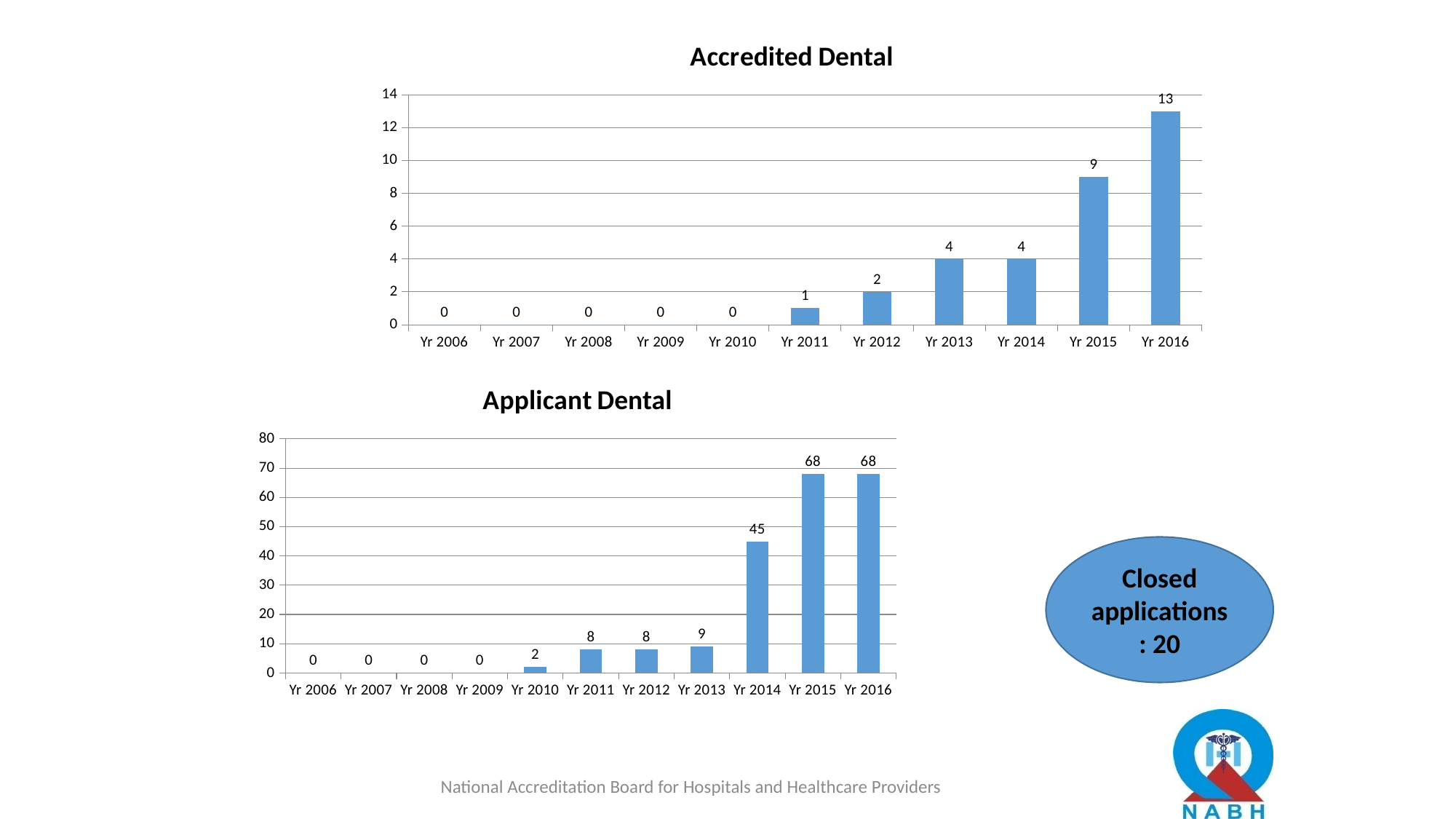
In the Accredited Dental chart, what is the value for Yr 2012? 2 In the Accredited Dental chart, how many years are shown on the x axis? 11 In the Applicant Dental chart, do the values generally rise or fall from Yr 2006 to Yr 2016? Rise In the Accredited Dental chart, what is the difference between Yr 2016 and Yr 2015? 4 In the Accredited Dental chart, what is the value for Yr 2016? 13 In the Applicant Dental chart, what is the value for Yr 2010? 2 In the Applicant Dental chart, which is larger, the value for Yr 2013 or the value for Yr 2014? Yr 2014 In the Accredited Dental chart, which year has the highest value? Yr 2016 In the Applicant Dental chart, how many years have a value of 0? 4 In the Applicant Dental chart, what is the value for Yr 2014? 45 In the Applicant Dental chart, what is the difference between Yr 2015 and Yr 2014? 23 What kind of chart is the Accredited Dental chart? Bar chart